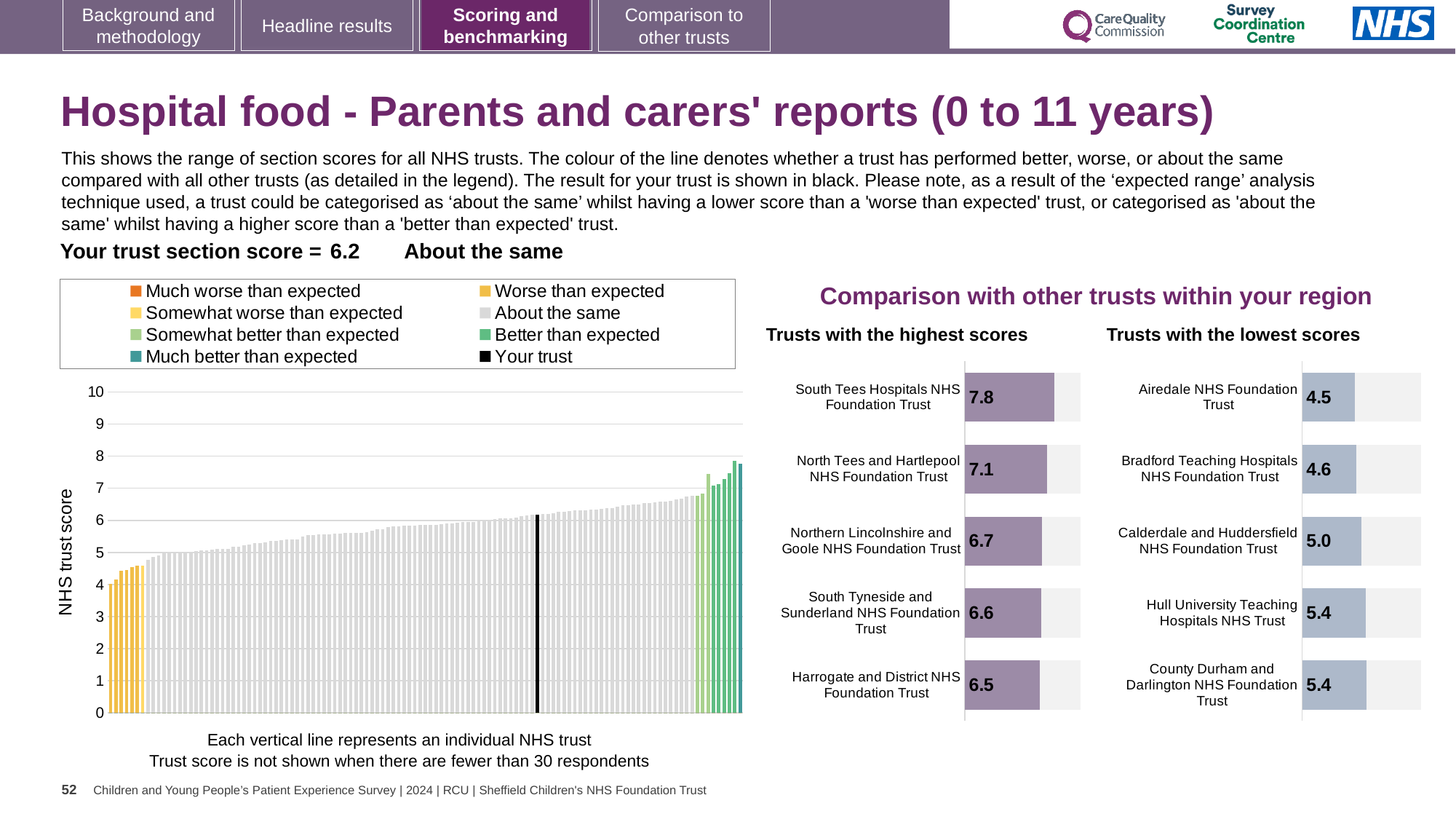
In the 'Trusts with the lowest scores' chart, which trust has the lowest score? Airedale NHS Foundation Trust In the 'Trusts with the highest scores' chart, what is the difference between the scores of South Tees Hospitals NHS Foundation Trust and Harrogate and District NHS Foundation Trust? 1.3 In the 'Trusts with the highest scores' chart, which trust has the highest score? South Tees Hospitals NHS Foundation Trust How many trusts are shown in the 'Trusts with the lowest scores' chart? 5 In the 'Trusts with the lowest scores' chart, what is the difference between the scores of Calderdale and Huddersfield NHS Foundation Trust and Airedale NHS Foundation Trust? 0.5 How many entries does the legend of the main 'NHS trust score' chart list? 8 In the main 'NHS trust score' chart on the left, do the bar values rise or fall from left to right? rise In the 'Trusts with the highest scores' chart, what is the score for South Tees Hospitals NHS Foundation Trust? 7.8 Which is larger: the score for North Tees and Hartlepool NHS Foundation Trust in the highest scores chart, or the score for Hull University Teaching Hospitals NHS Trust in the lowest scores chart? North Tees and Hartlepool NHS Foundation Trust In the main 'NHS trust score' chart on the left, what is the section score for your trust (the black bar)? 6.2 In the 'Trusts with the lowest scores' chart, what is the score for Calderdale and Huddersfield NHS Foundation Trust? 5.0 In the 'Trusts with the highest scores' chart, what is the score for Harrogate and District NHS Foundation Trust? 6.5